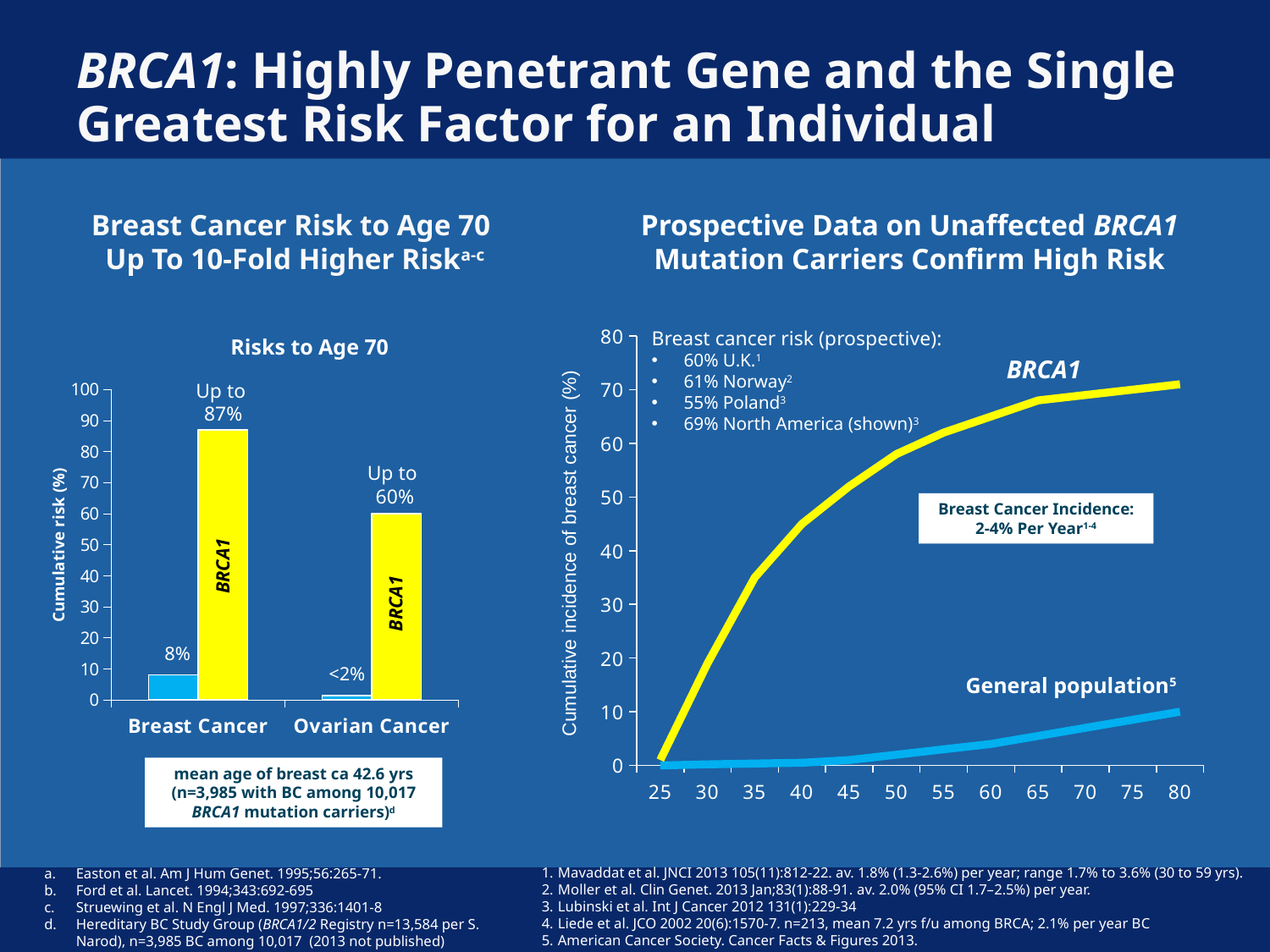
In the 'Risks to Age 70' chart, how many cancer categories are shown on the x axis? 2 In the right-hand chart, how many lines are plotted? 2 In the 'Risks to Age 70' chart, what is the BRCA1 breast cancer risk to age 70? Up to 87% In the 'Risks to Age 70' chart, what is the non-BRCA1 breast cancer risk value shown? 8% In the right-hand chart, is the BRCA1 cumulative incidence at age 80 greater or less than 60? greater What kind of chart is the chart on the right side of the slide? Line chart In the 'Risks to Age 70' chart, what is the non-BRCA1 ovarian cancer risk value shown? <2% In the right-hand chart, does the BRCA1 line rise or fall as age increases from 25 to 80? Rise What kind of chart is the 'Risks to Age 70' chart? Bar chart In the 'Risks to Age 70' chart, what is the label of the y axis? Cumulative risk (%) In the 'Risks to Age 70' chart, which cancer type has the higher BRCA1 risk bar? Breast Cancer In the 'Risks to Age 70' chart, what is the BRCA1 ovarian cancer risk to age 70? Up to 60%